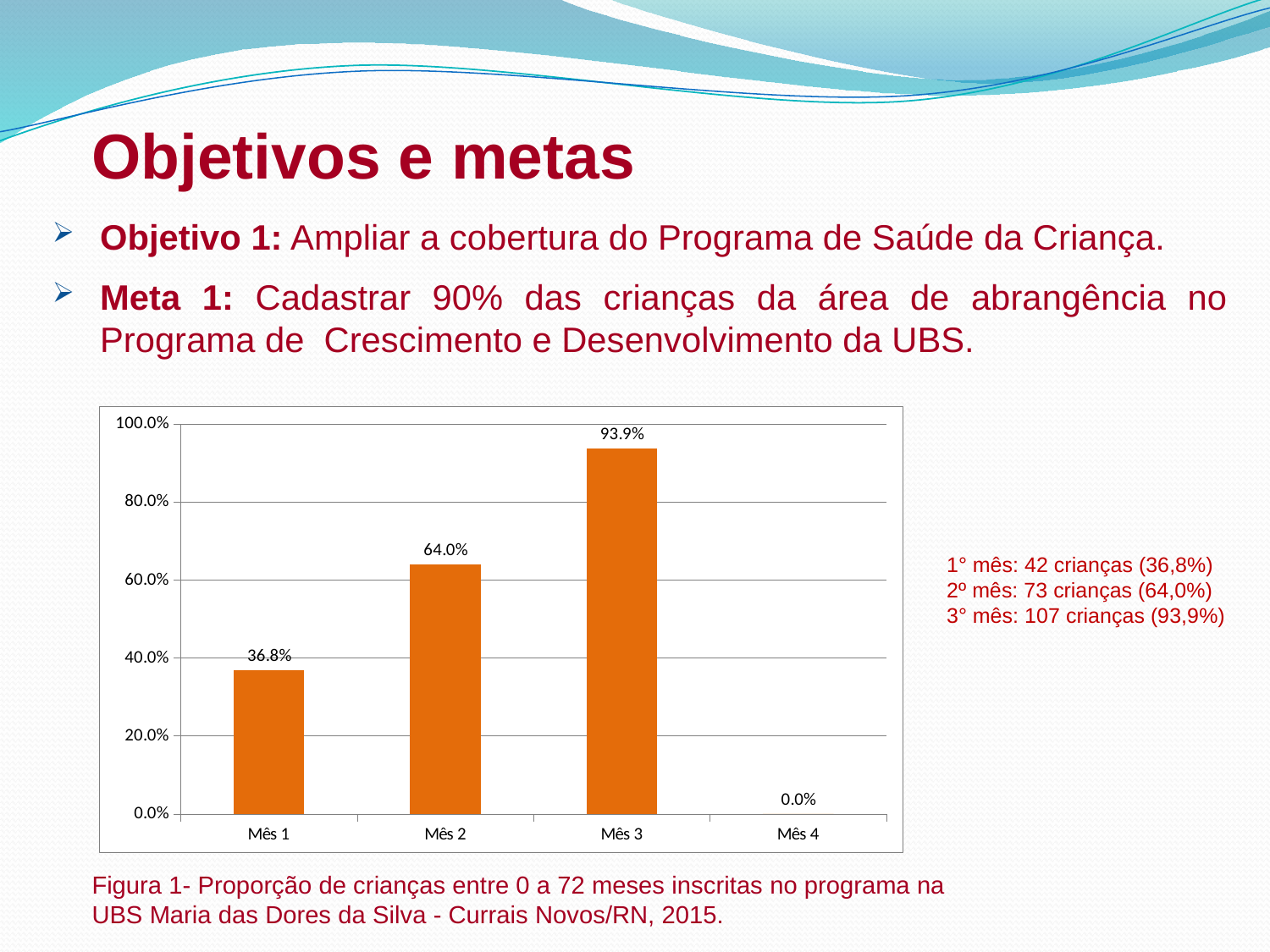
What is the difference between the values for Mês 3 and Mês 2? 29.9% What kind of chart is shown on the slide? bar chart What is the value for Mês 2? 64.0% Which is larger, the value for Mês 1 or the value for Mês 2? Mês 2 What is the value for Mês 1? 36.8% Which month has the lowest value? Mês 4 What is the value for Mês 3? 93.9% How many months are shown on the x axis? 4 Is the value for Mês 3 greater or less than 80.0%? greater What is the value for Mês 4? 0.0% What is the difference between the values for Mês 2 and Mês 1? 27.2% Which month has the highest value? Mês 3